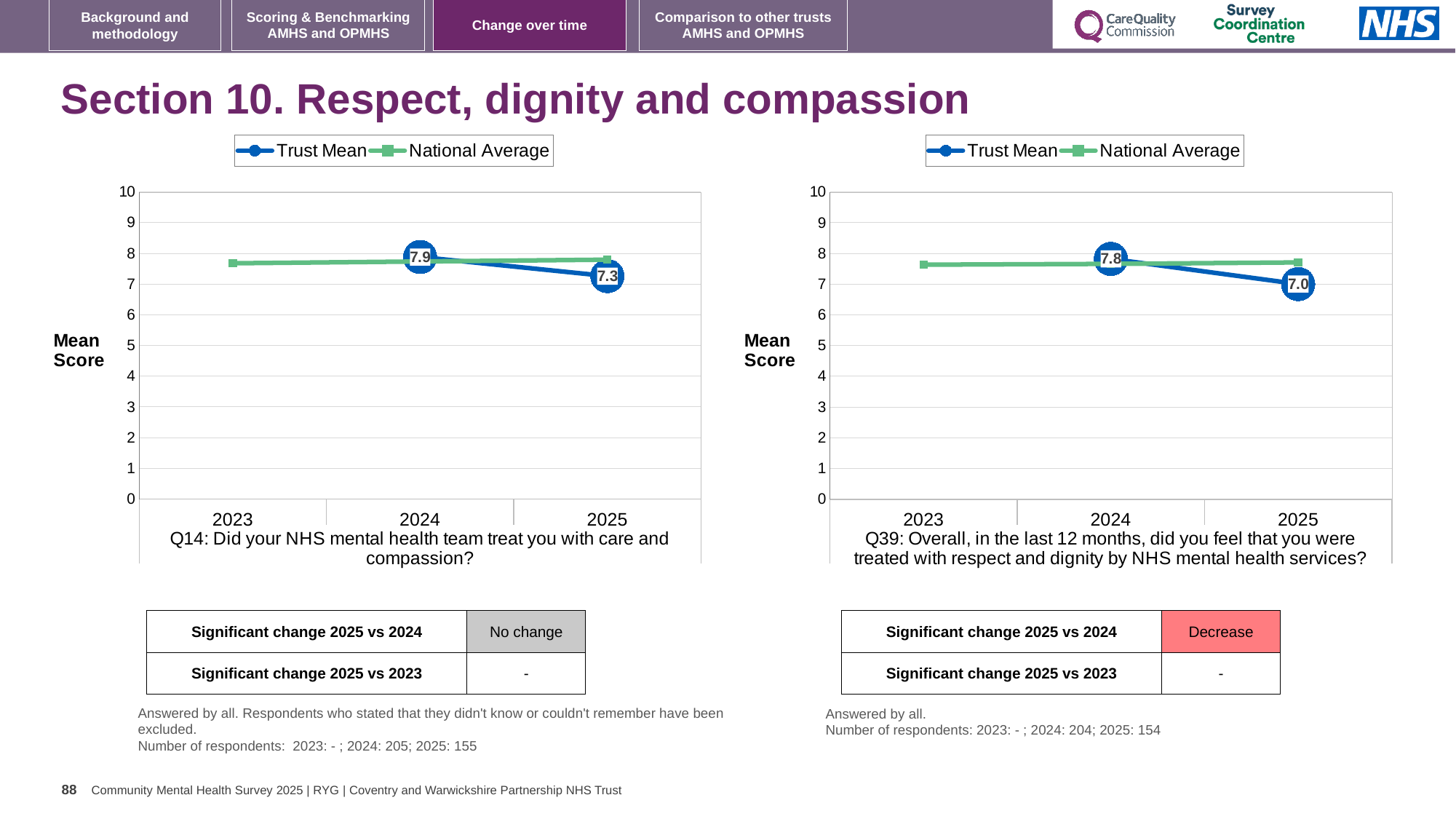
In the Q14 chart on the left, does the Trust Mean rise or fall from 2024 to 2025? Fall In the Q39 chart on the right, what is the difference between the Trust Mean in 2024 and in 2025? 0.8 In the Q14 chart on the left, is the National Average for 2023 greater or less than 8? less In the Q14 chart on the left, what is the Trust Mean for 2024? 7.9 In the Q39 chart on the right, which is larger in 2025: the Trust Mean or the National Average? National Average In the Q39 chart on the right, what is the Trust Mean for 2025? 7.0 In the Q39 chart on the right, what is the Trust Mean for 2024? 7.8 In the Q14 chart on the left, what is the Trust Mean for 2025? 7.3 In the Q14 chart on the left, by how much did the Trust Mean fall from 2024 to 2025? 0.6 How many series does the legend of the Q14 chart on the left list? 2 How many years are shown on the x axis of the Q39 chart on the right? 3 What type of chart is the Q39 chart on the right? Line chart